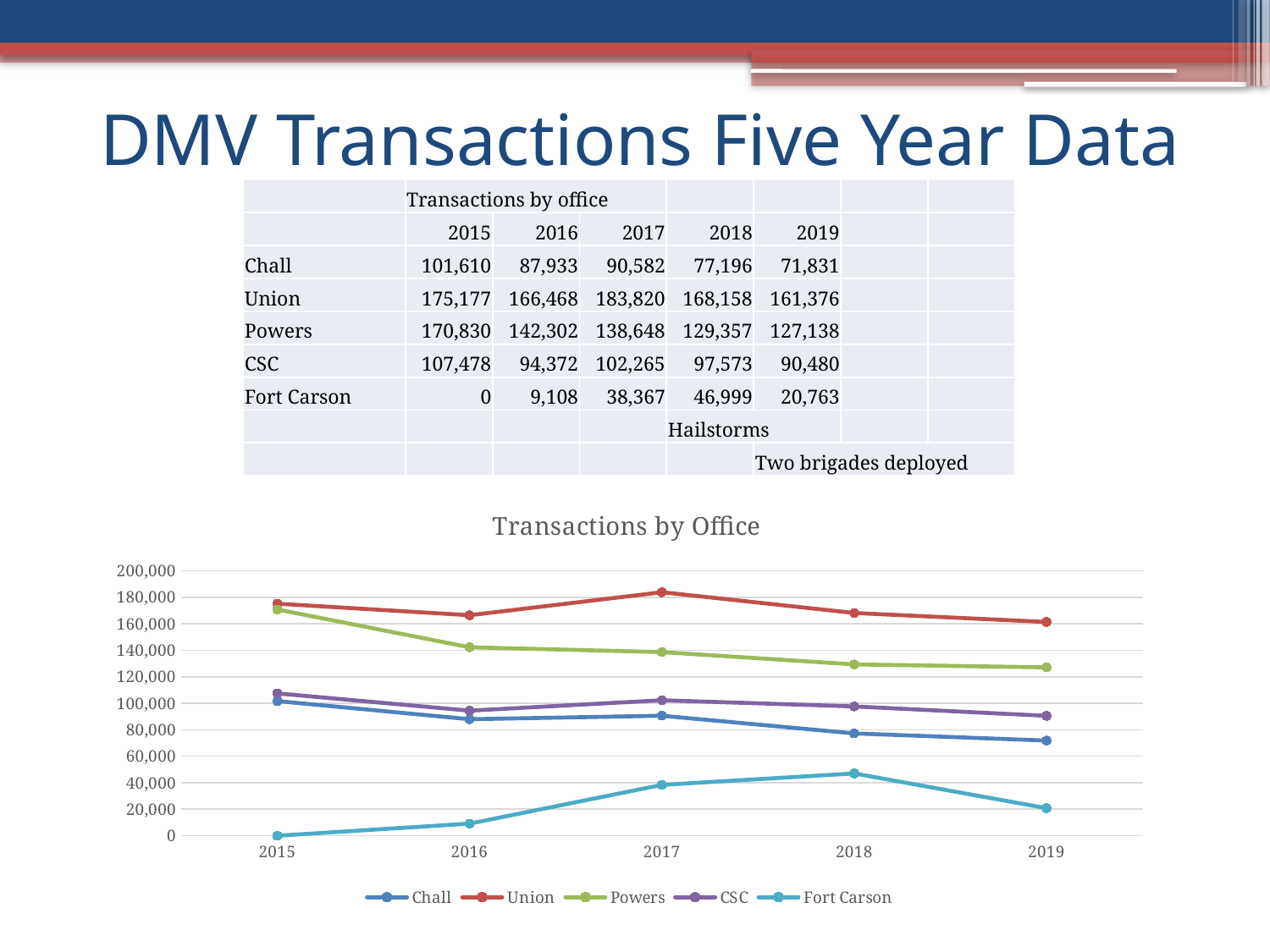
How many series does the chart legend list? 5 Which office had the highest number of transactions in 2017? Union How many transactions did Fort Carson have in 2018? 46,999 What kind of chart is shown on the slide? line chart How many transactions did Union have in 2017? 183,820 What is the difference between Powers' transactions in 2015 and 2019? 43,692 Which had more transactions in 2016, Chall or CSC? CSC How many years are plotted along the x axis of the chart? 5 Do Powers' transactions rise or fall from 2015 to 2019? fall Is the value for Powers in 2018 greater or less than 140,000? less Which office had the lowest number of transactions in 2015? Fort Carson What is the title of the chart? Transactions by Office